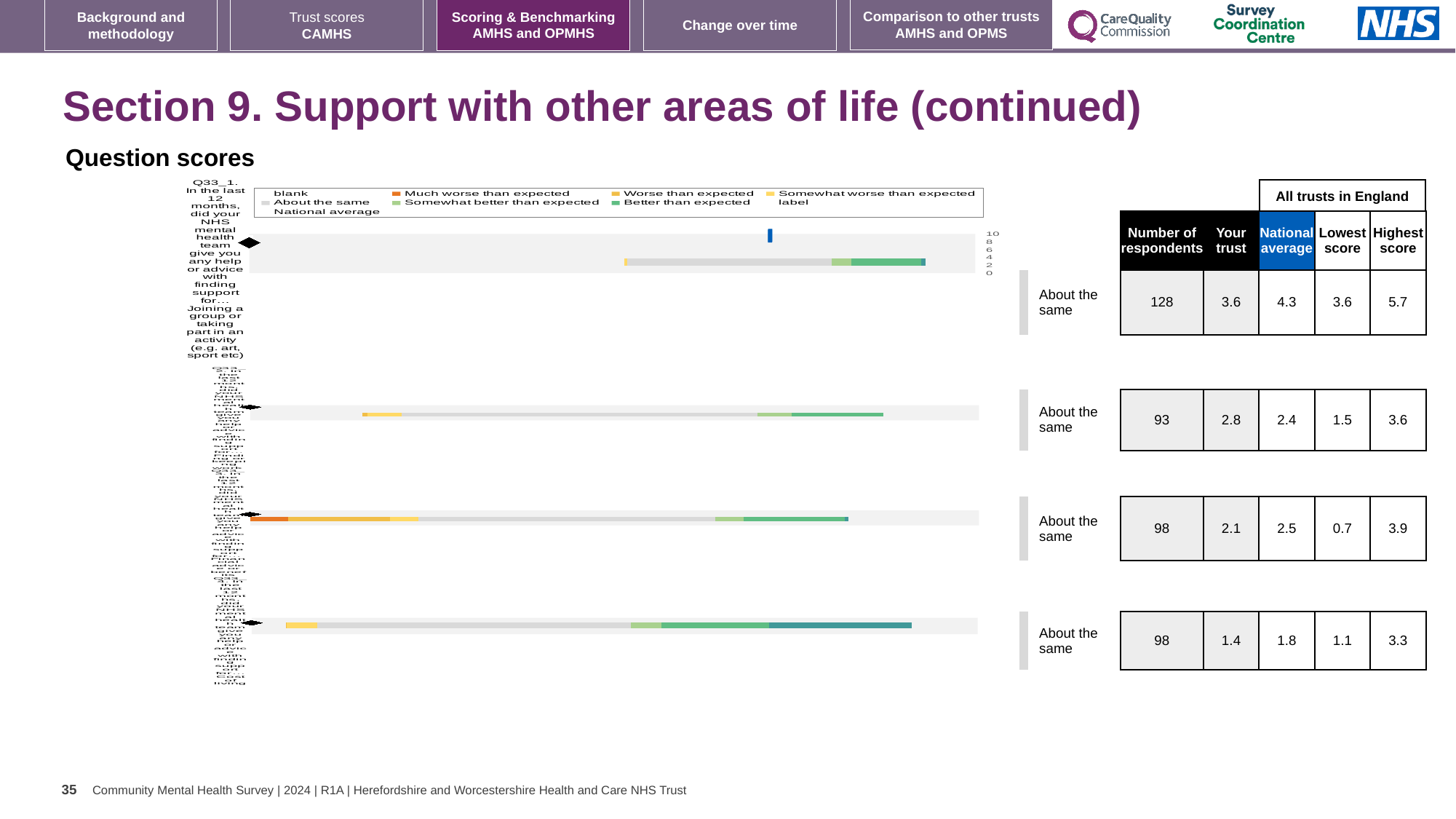
How many question score charts are shown on the slide? 4 For the top chart (Q33_1), what is the difference between the highest score and the lowest score across all trusts in England? 2.1 For the top chart (Q33_1), what is the national average score shown in the table? 4.3 For the top chart (Q33_1), which is larger: the 'Your trust' score or the national average? National average What kind of chart is used to show the question scores on this slide? bar chart Which of the four charts has the highest 'Your trust' score in the table? The top chart (Q33_1) For the top chart (Q33_1, help with joining a group or taking part in an activity), what is the 'Your trust' score shown in the table? 3.6 For the third chart from the top, what is the lowest score across all trusts in England? 0.7 What benchmark label is shown next to each of the four charts? About the same For the second chart from the top, what is the 'Your trust' score shown in the table? 2.8 For the bottom chart, what is the highest score across all trusts in England? 3.3 For the top chart (Q33_1), how many respondents are listed in the table? 128